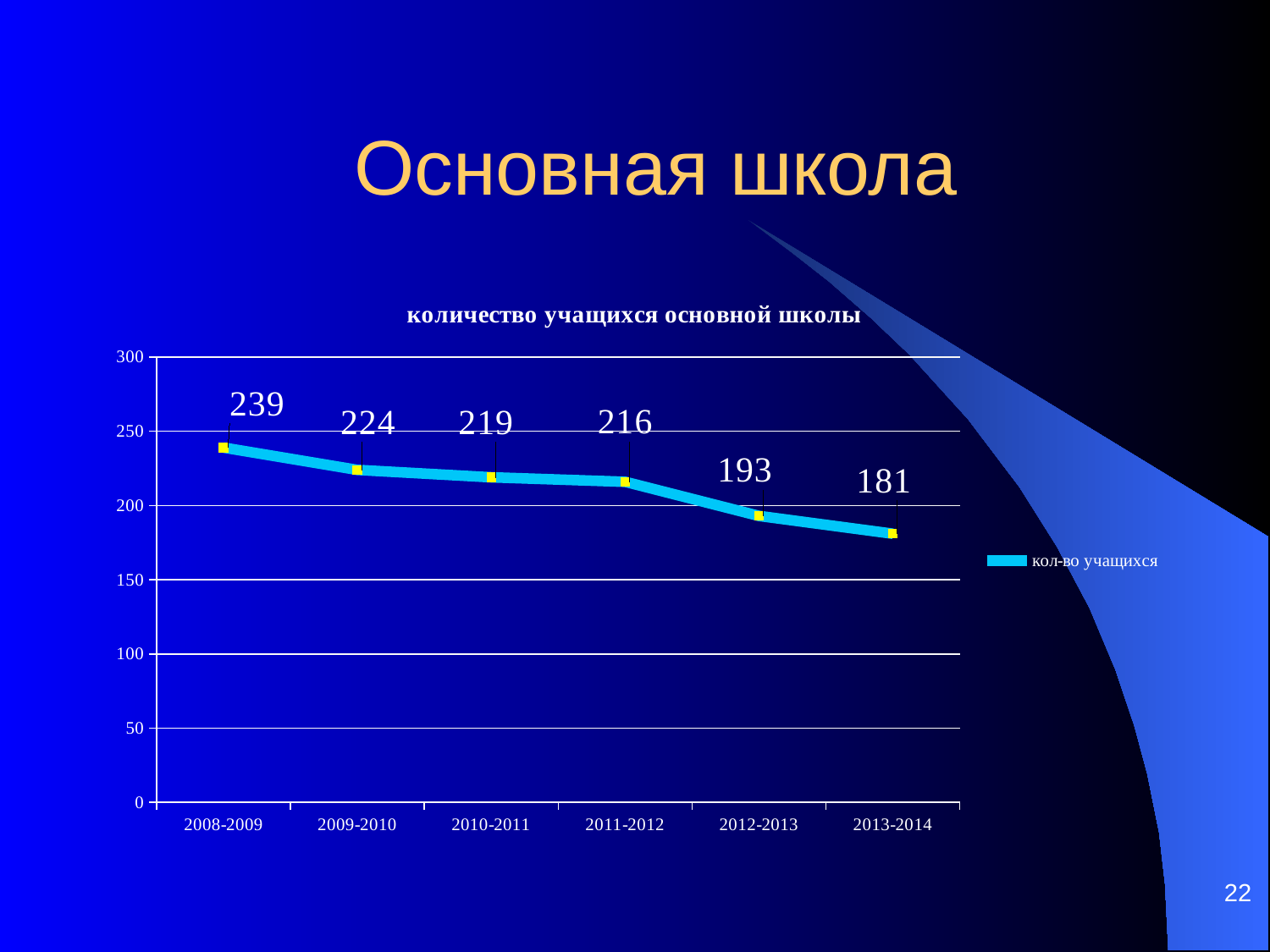
Do the values rise or fall from 2008-2009 to 2013-2014? fall Which is larger, the value for 2009-2010 or the value for 2012-2013? 2009-2010 Which school year has the lowest number of students? 2013-2014 How many school years are shown on the x axis? 6 Is the value for 2012-2013 greater or less than 200? less What is the value for 2011-2012? 216 What is the number of students in 2013-2014? 181 What is the difference between the values for 2008-2009 and 2013-2014? 58 Which school year has the highest number of students? 2008-2009 What is the difference between the values for 2011-2012 and 2012-2013? 23 What is the number of students in 2008-2009? 239 What kind of chart is shown on the slide? line chart